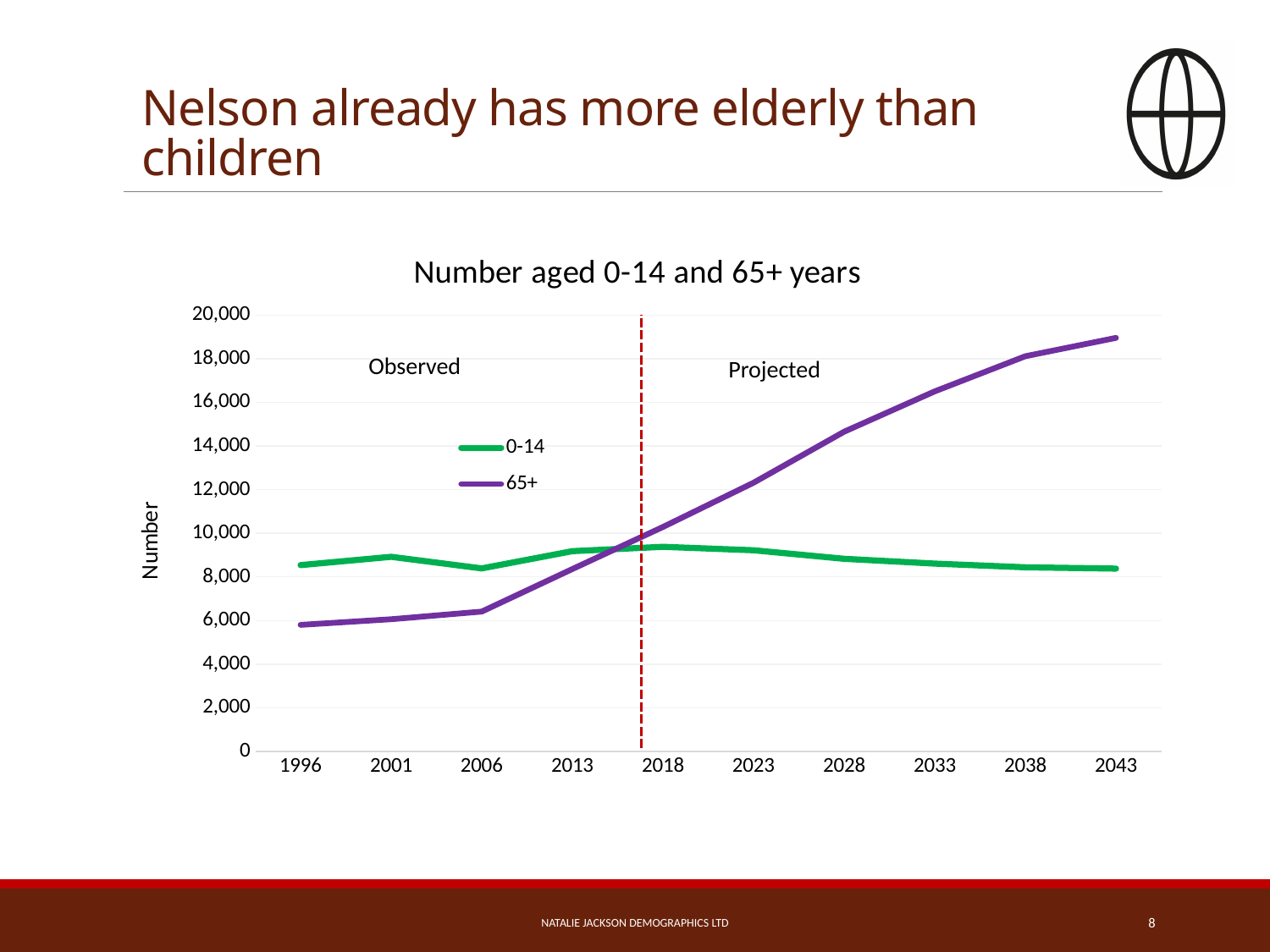
What kind of chart is shown on the slide? line chart Does the 65+ series rise or fall from 1996 to 2043? rise Is the value for 65+ in 2043 greater or less than 18,000? greater What is the title of the chart? Number aged 0-14 and 65+ years Is the value for 0-14 in 1996 greater or less than 8,000? greater Is the value for 65+ in 2028 greater or less than 14,000? greater How many years are marked along the x axis of the chart? 10 Which series is drawn in purple? 65+ In 1996, which series has the larger value, 0-14 or 65+? 0-14 In 2043, which series has the larger value, 0-14 or 65+? 65+ How many series does the chart's legend list? 2